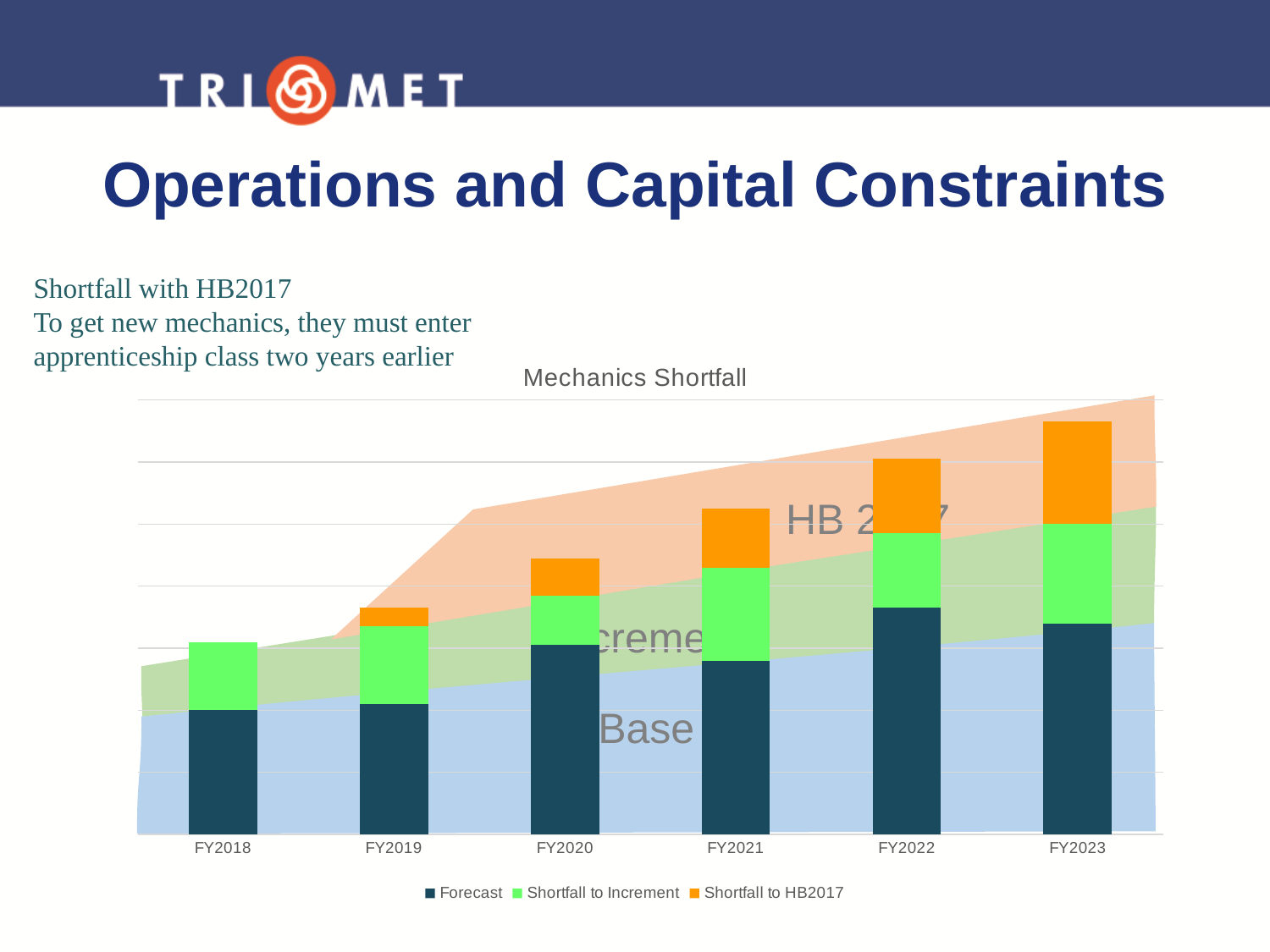
How many fiscal years are shown on the x axis of the chart? 6 Do the total heights of the stacked bars rise or fall from FY2018 to FY2023? Rise Which series is shown in orange in the chart? Shortfall to HB2017 How many of the bars include a Shortfall to HB2017 segment? 5 Is the Forecast segment larger in FY2023 or in FY2018? FY2023 How many series does the chart legend list? 3 What is the title of the chart? Mechanics Shortfall Does the Forecast series rise or fall across the fiscal years shown? Rise What kind of chart is shown on the slide? Stacked bar chart Is the Shortfall to Increment segment larger in FY2021 or in FY2019? FY2021 Which fiscal year has the shortest stacked bar? FY2018 Which fiscal year has the tallest stacked bar? FY2023